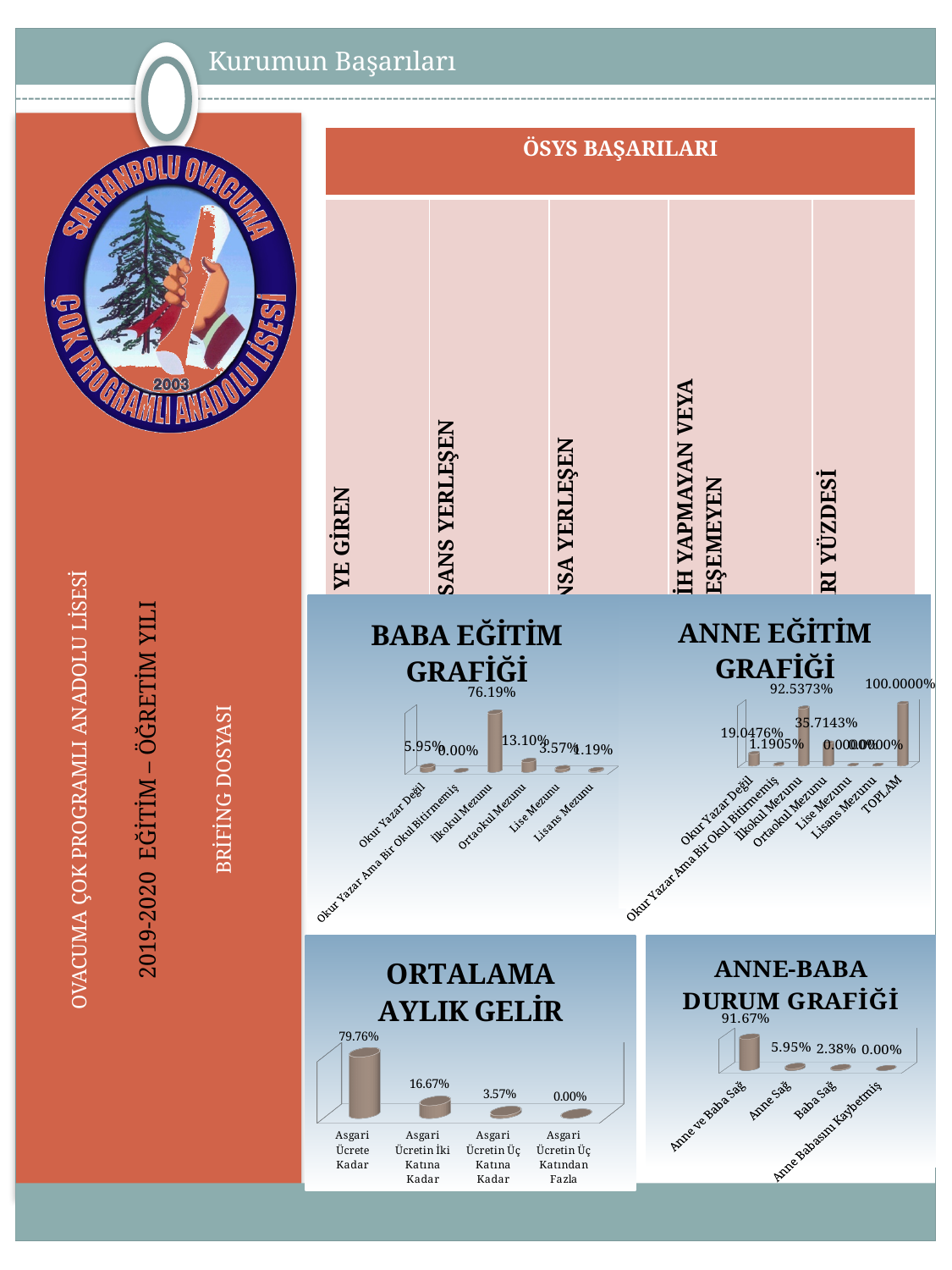
In the ORTALAMA AYLIK GELİR chart, which category has the lowest value? Asgari Ücretin Üç Katından Fazla In the ORTALAMA AYLIK GELİR chart, what is the value for Asgari Ücrete Kadar? 79.76% In the ANNE-BABA DURUM GRAFİĞİ chart, which is larger, Anne Sağ or Baba Sağ? Anne Sağ In the ANNE EĞİTİM GRAFİĞİ chart, what is the value for TOPLAM? 100.0000% In the BABA EĞİTİM GRAFİĞİ chart, what is the value for Ortaokul Mezunu? 13.10% In the ANNE-BABA DURUM GRAFİĞİ chart, what is the value for Anne ve Baba Sağ? 91.67% In the BABA EĞİTİM GRAFİĞİ chart, what is the value for İlkokul Mezunu? 76.19% In the ANNE EĞİTİM GRAFİĞİ chart, what is the value for Okur Yazar Değil? 19.0476% In the BABA EĞİTİM GRAFİĞİ chart, which category has the highest value? İlkokul Mezunu How many categories are shown in the BABA EĞİTİM GRAFİĞİ chart? 6 In the ORTALAMA AYLIK GELİR chart, what is the difference between Asgari Ücrete Kadar and Asgari Ücretin İki Katına Kadar? 63.09% In the BABA EĞİTİM GRAFİĞİ chart, what is the difference between İlkokul Mezunu and Ortaokul Mezunu? 63.09%